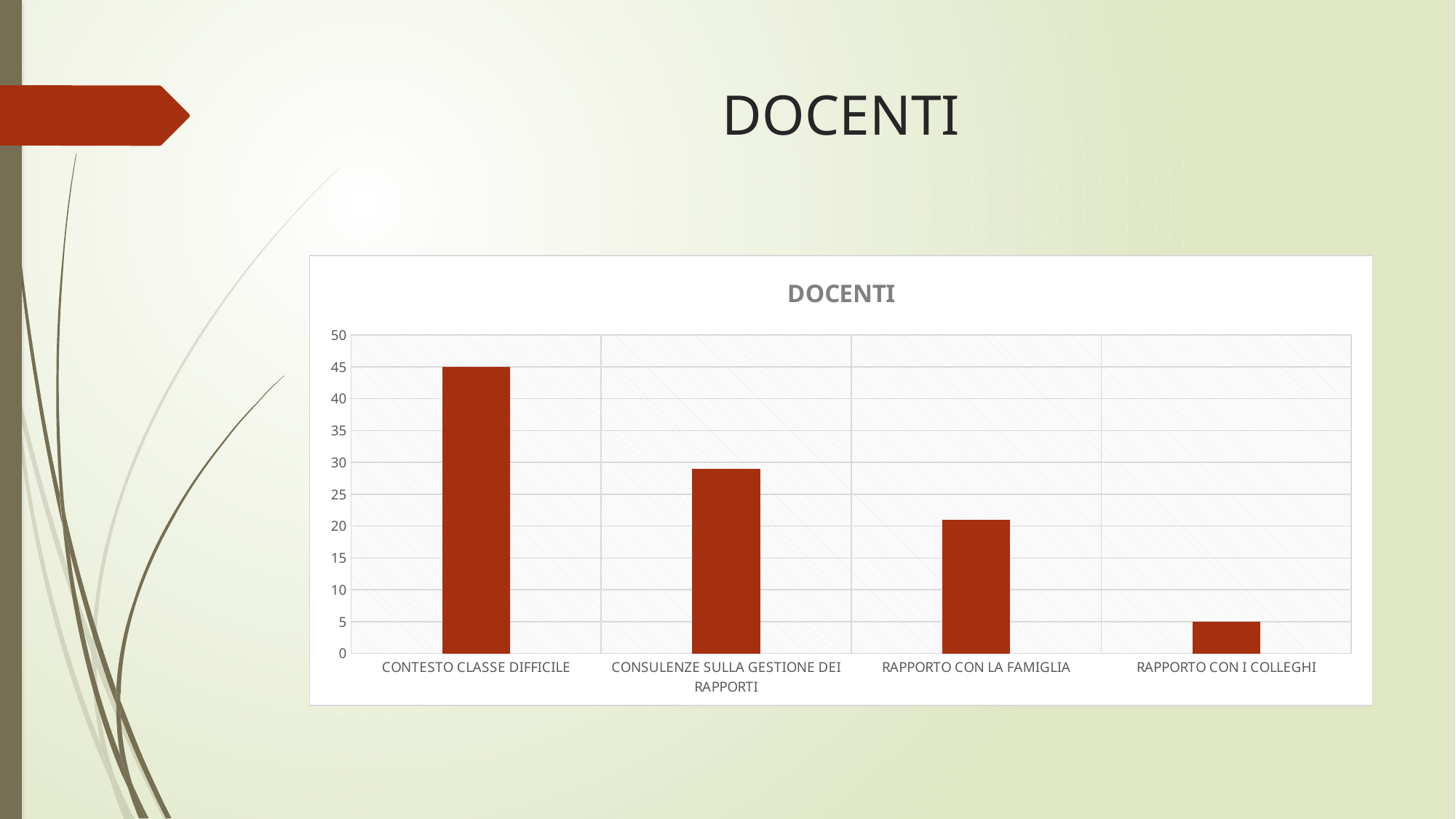
Which category has the highest value? CONTESTO CLASSE DIFFICILE Do the bar values rise or fall from left to right along the x axis? fall What is the title of the chart? DOCENTI Is the value for CONSULENZE SULLA GESTIONE DEI RAPPORTI greater or less than 25? greater Which category has the lowest value? RAPPORTO CON I COLLEGHI What is the difference between the values for CONTESTO CLASSE DIFFICILE and RAPPORTO CON I COLLEGHI? 40 What is the value for RAPPORTO CON I COLLEGHI? 5 What is the value for CONTESTO CLASSE DIFFICILE? 45 Which is larger, the value for CONSULENZE SULLA GESTIONE DEI RAPPORTI or the value for RAPPORTO CON LA FAMIGLIA? CONSULENZE SULLA GESTIONE DEI RAPPORTI How many categories are shown on the x axis of the chart? 4 Is the value for RAPPORTO CON LA FAMIGLIA greater or less than 25? less What type of chart is shown on the slide? bar chart